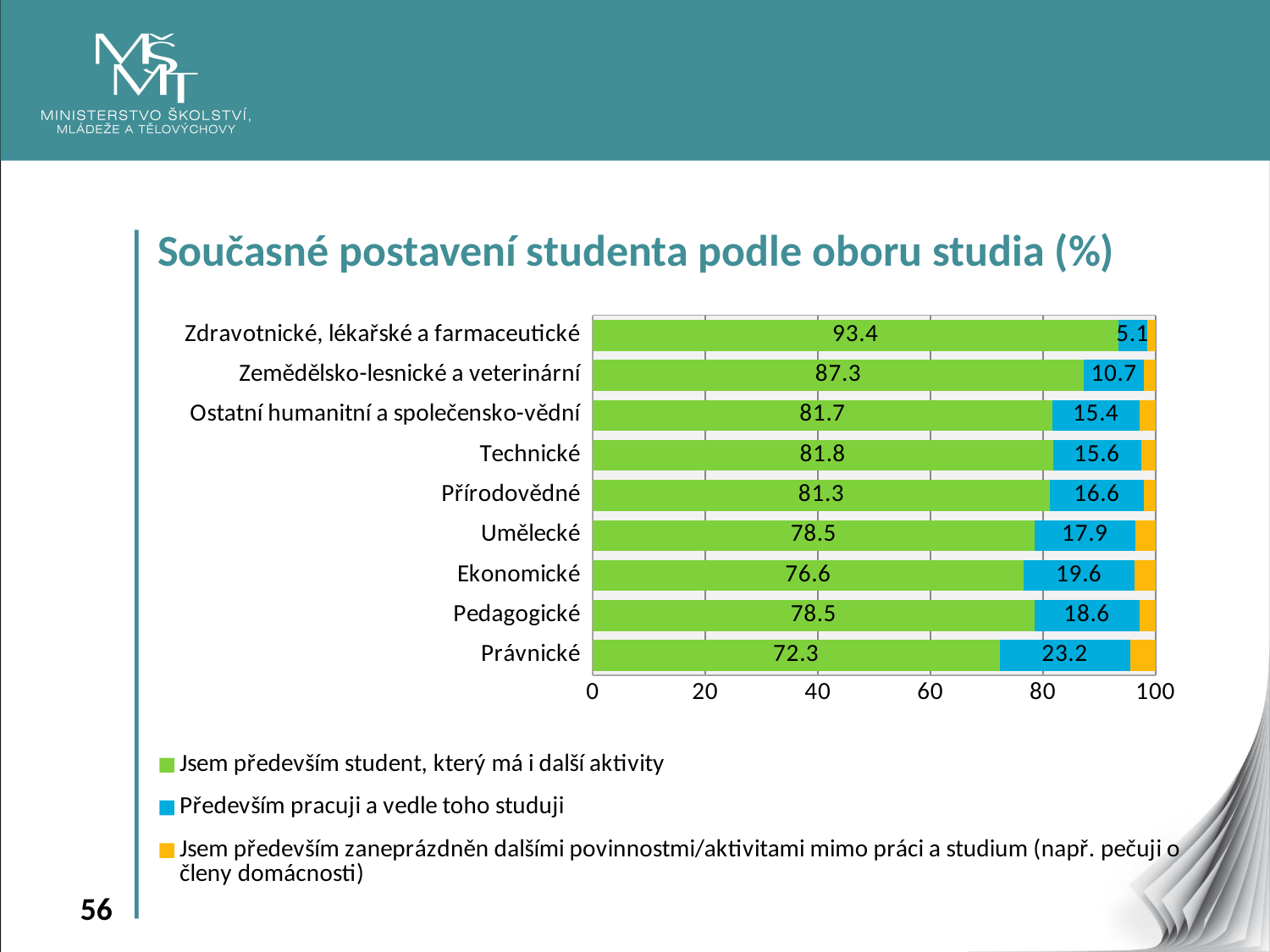
What is the value of "Především pracuji a vedle toho studuji" for Ekonomické? 19.6 Which field of study has the lowest value for "Jsem především student, který má i další aktivity"? Právnické Which field of study has the lowest value for "Především pracuji a vedle toho studuji"? Zdravotnické, lékařské a farmaceutické What is the difference between the "Jsem především student, který má i další aktivity" values for Zdravotnické, lékařské a farmaceutické and Právnické? 21.1 What is the value of "Především pracuji a vedle toho studuji" for Právnické? 23.2 How many series does the legend list? 3 Which field of study has the highest value for "Jsem především student, který má i další aktivity"? Zdravotnické, lékařské a farmaceutické What is the title of the chart? Současné postavení studenta podle oboru studia (%) What is the value of "Jsem především student, který má i další aktivity" for Zdravotnické, lékařské a farmaceutické? 93.4 What kind of chart is shown on the slide? bar chart Which has a larger value for "Především pracuji a vedle toho studuji": Umělecké or Zemědělsko-lesnické a veterinární? Umělecké How many fields of study (categories) are shown in the chart? 9